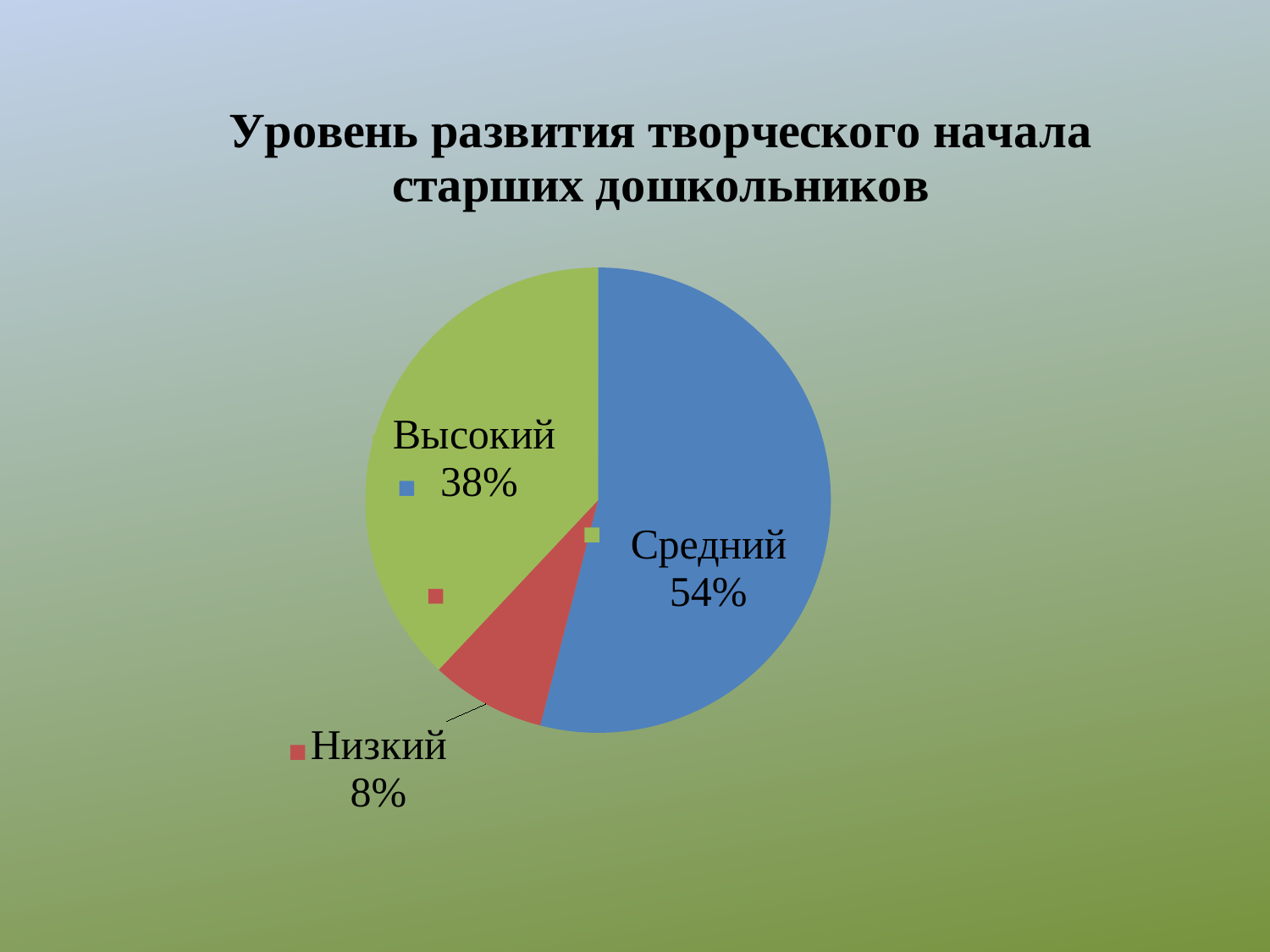
How many slices does the pie chart have? 3 Which is larger, the Высокий slice or the Низкий slice? Высокий Which category has the smallest share of the pie? Низкий What percentage is shown for the Высокий slice? 38% Which category has the largest share of the pie? Средний What is the title of the chart on the slide? Уровень развития творческого начала старших дошкольников What is the combined share of the Высокий and Низкий slices? 46% What type of chart is shown on the slide? pie chart What is the difference in percentage points between the Высокий and Низкий slices? 30 What is the difference in percentage points between the Средний and Высокий slices? 16 What percentage is shown for the Низкий slice? 8% What percentage is shown for the Средний slice? 54%